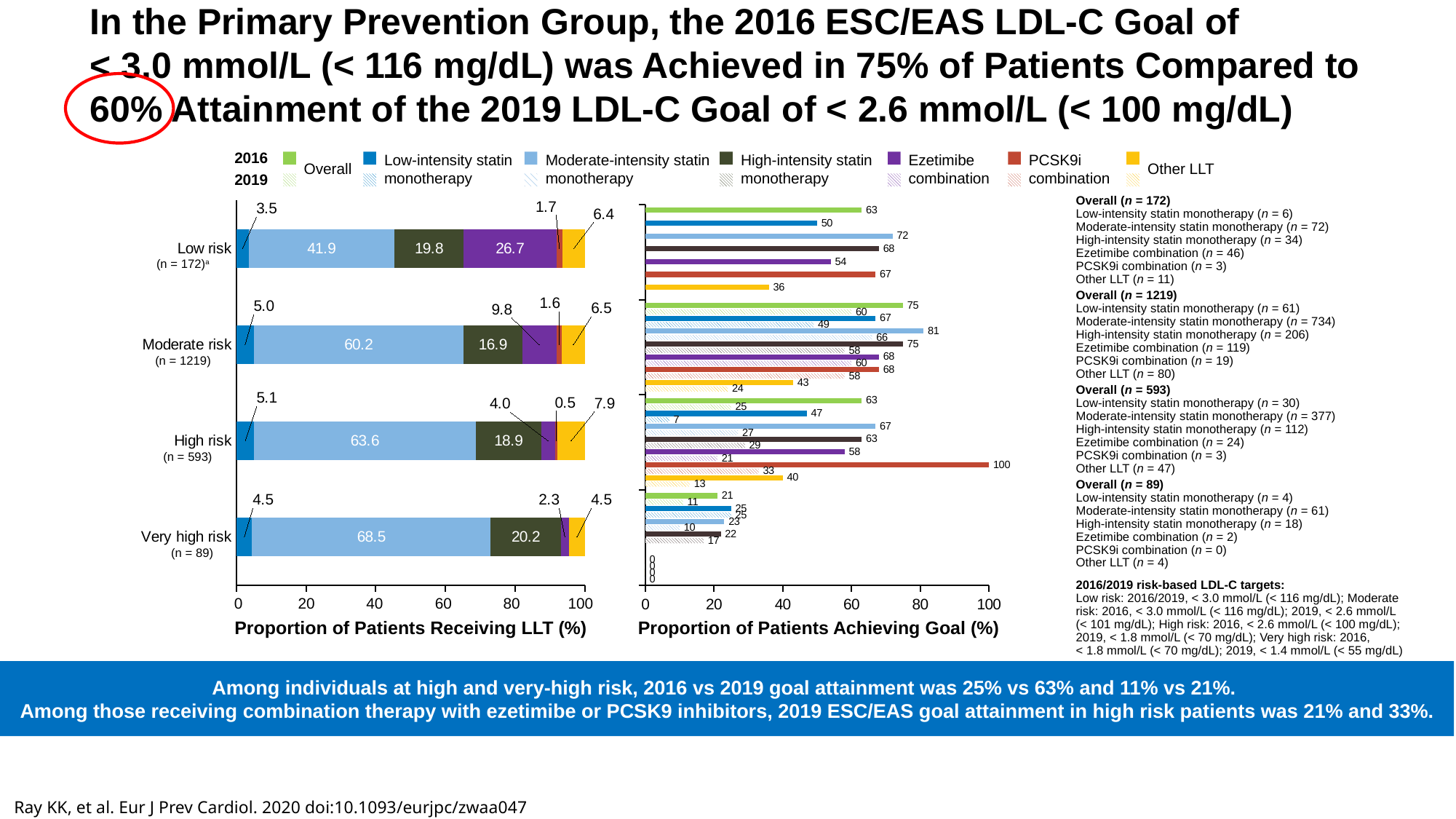
In the 'Proportion of Patients Achieving Goal (%)' chart, what was the overall 2016 goal attainment for moderate risk patients? 75 How many risk groups are shown on the y axis of the 'Proportion of Patients Receiving LLT (%)' chart? 4 In the 'Proportion of Patients Achieving Goal (%)' chart, what was the overall 2019 goal attainment for high risk patients? 25 In the 'Proportion of Patients Receiving LLT (%)' chart, what is the difference between the moderate-intensity statin monotherapy proportions for very high risk and low risk patients? 26.6 In the 'Proportion of Patients Achieving Goal (%)' chart, what was the 2016 goal attainment for high risk patients on PCSK9i combination? 100 In the 'Proportion of Patients Receiving LLT (%)' chart, which risk group has the highest proportion receiving moderate-intensity statin monotherapy? Very high risk What type of chart is the 'Proportion of Patients Receiving LLT (%)' chart? Stacked bar chart In the 'Proportion of Patients Receiving LLT (%)' chart, what proportion of high risk patients received high-intensity statin monotherapy? 18.9 In the 'Proportion of Patients Receiving LLT (%)' chart, what proportion of low risk patients received ezetimibe combination? 26.7 In the 'Proportion of Patients Achieving Goal (%)' chart, for very high risk patients, was overall goal attainment higher in 2016 or 2019? 2016 In the 'Proportion of Patients Achieving Goal (%)' chart, what is the difference between overall 2016 and 2019 goal attainment for moderate risk patients? 15 In the 'Proportion of Patients Receiving LLT (%)' chart, what proportion of very high risk patients received moderate-intensity statin monotherapy? 68.5